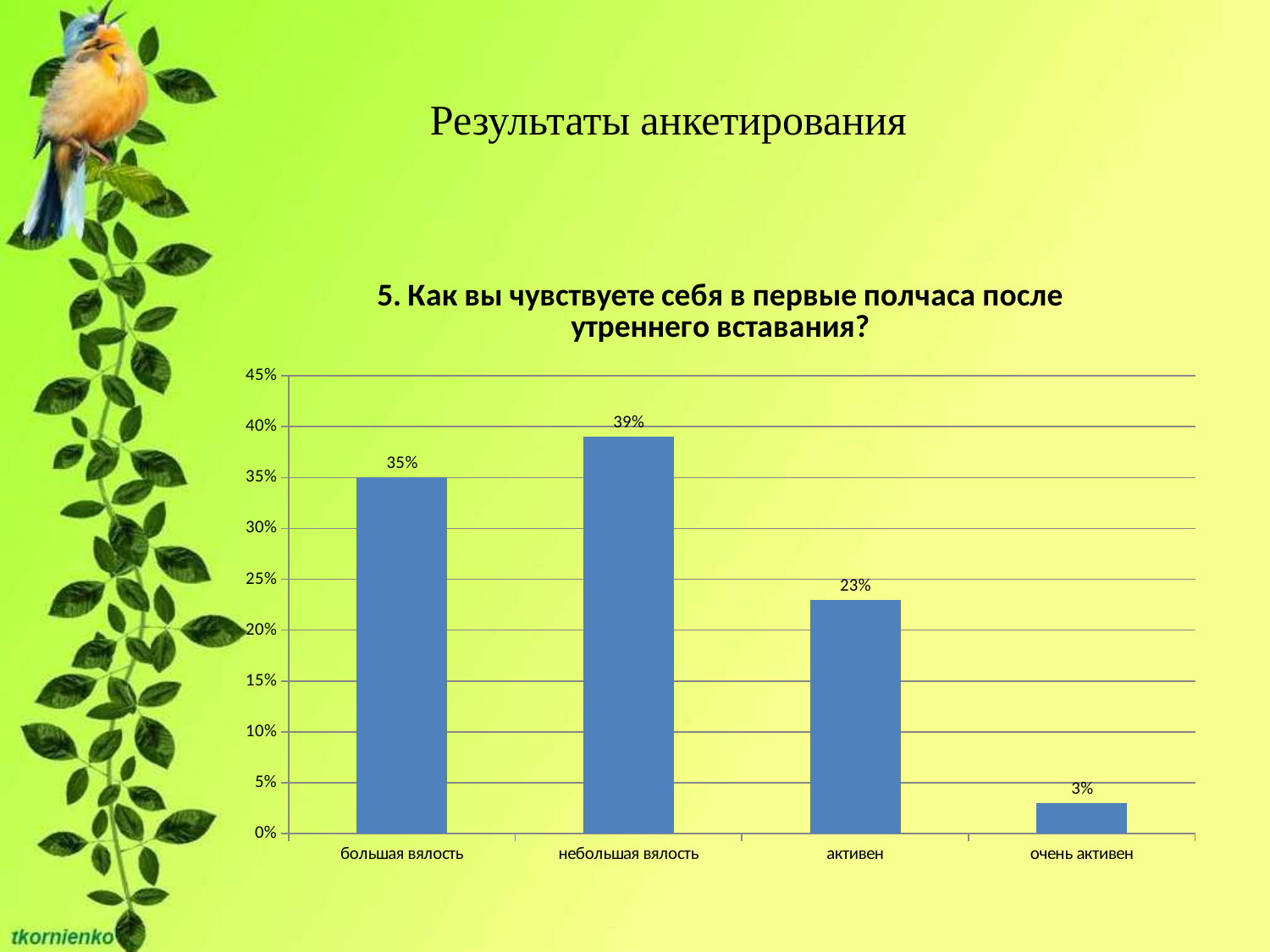
What is the value for "очень активен"? 3% What is the difference between the values for "активен" and "очень активен"? 20% How many categories are shown on the x axis? 4 What is the difference between the values for "небольшая вялость" and "большая вялость"? 4% What is the title of the chart? 5. Как вы чувствуете себя в первые полчаса после утреннего вставания? What is the value for "активен"? 23% Which category has the lowest value? очень активен Which is larger, the value for "большая вялость" or the value for "активен"? большая вялость Which category has the highest value? небольшая вялость What is the value for "большая вялость"? 35% What is the value for "небольшая вялость"? 39% What kind of chart is shown on the slide? bar chart